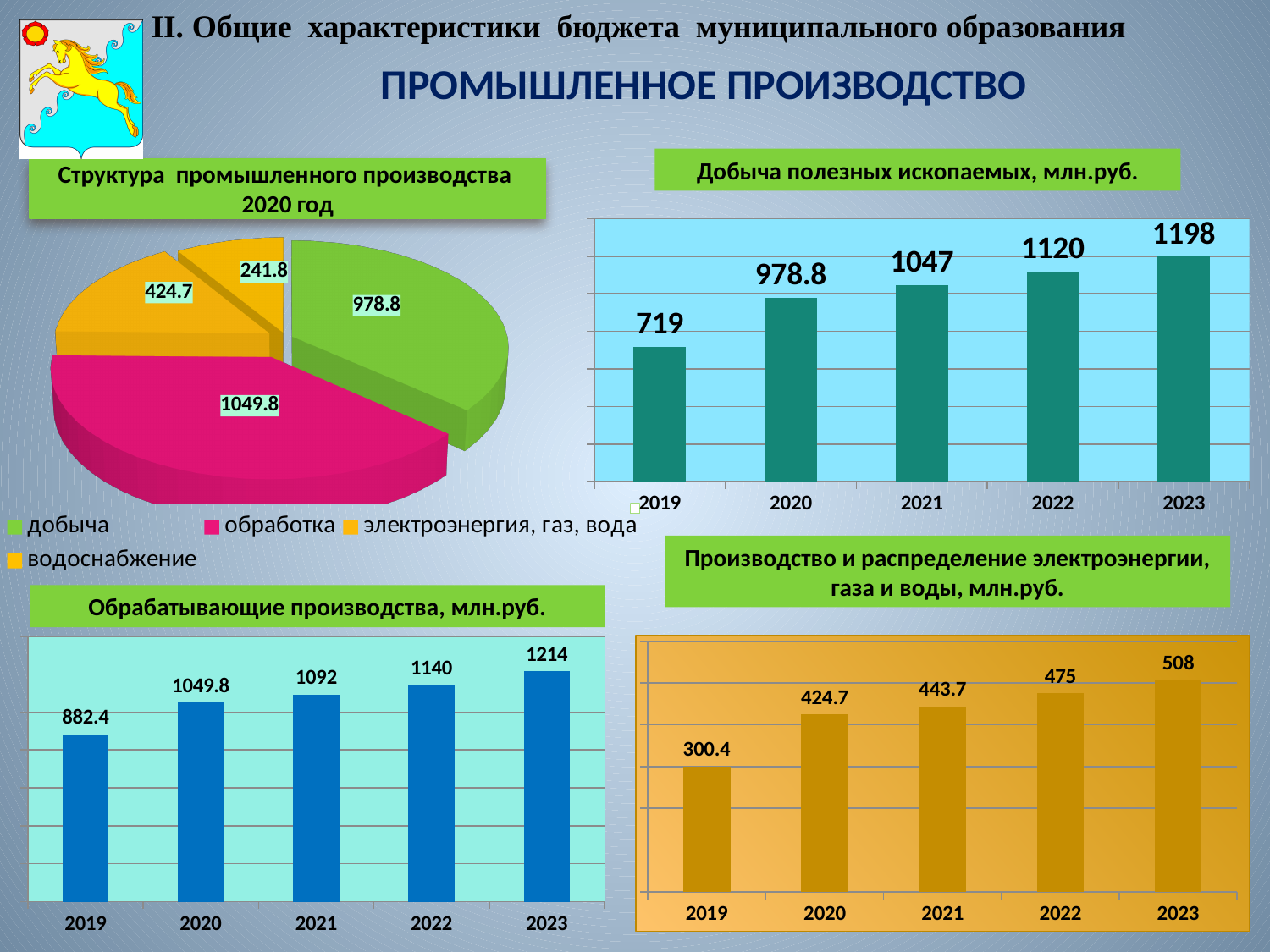
In the chart 'Производство и распределение электроэнергии, газа и воды, млн.руб.', what is the difference between the 2020 and 2019 values? 124.3 In the chart 'Добыча полезных ископаемых, млн.руб.', by how much does the 2023 value exceed the 2019 value? 479 In the chart 'Добыча полезных ископаемых, млн.руб.', what is the value for 2021? 1047 How many entries does the legend of the pie chart 'Структура промышленного производства 2020 год' list? 4 What kind of chart is 'Добыча полезных ископаемых, млн.руб.'? bar chart In the pie chart 'Структура промышленного производства 2020 год', what is the value of the largest slice? 1049.8 In the chart 'Обрабатывающие производства, млн.руб.', do the values rise or fall from 2019 to 2023? rise Which is larger for 2022: the value in 'Добыча полезных ископаемых, млн.руб.' or the value in 'Обрабатывающие производства, млн.руб.'? Обрабатывающие производства In the chart 'Обрабатывающие производства, млн.руб.', what is the value for 2019? 882.4 How many years are shown in the chart 'Производство и распределение электроэнергии, газа и воды, млн.руб.'? 5 In the chart 'Производство и распределение электроэнергии, газа и воды, млн.руб.', which year has the highest value? 2023 What kind of chart is 'Структура промышленного производства 2020 год'? pie chart